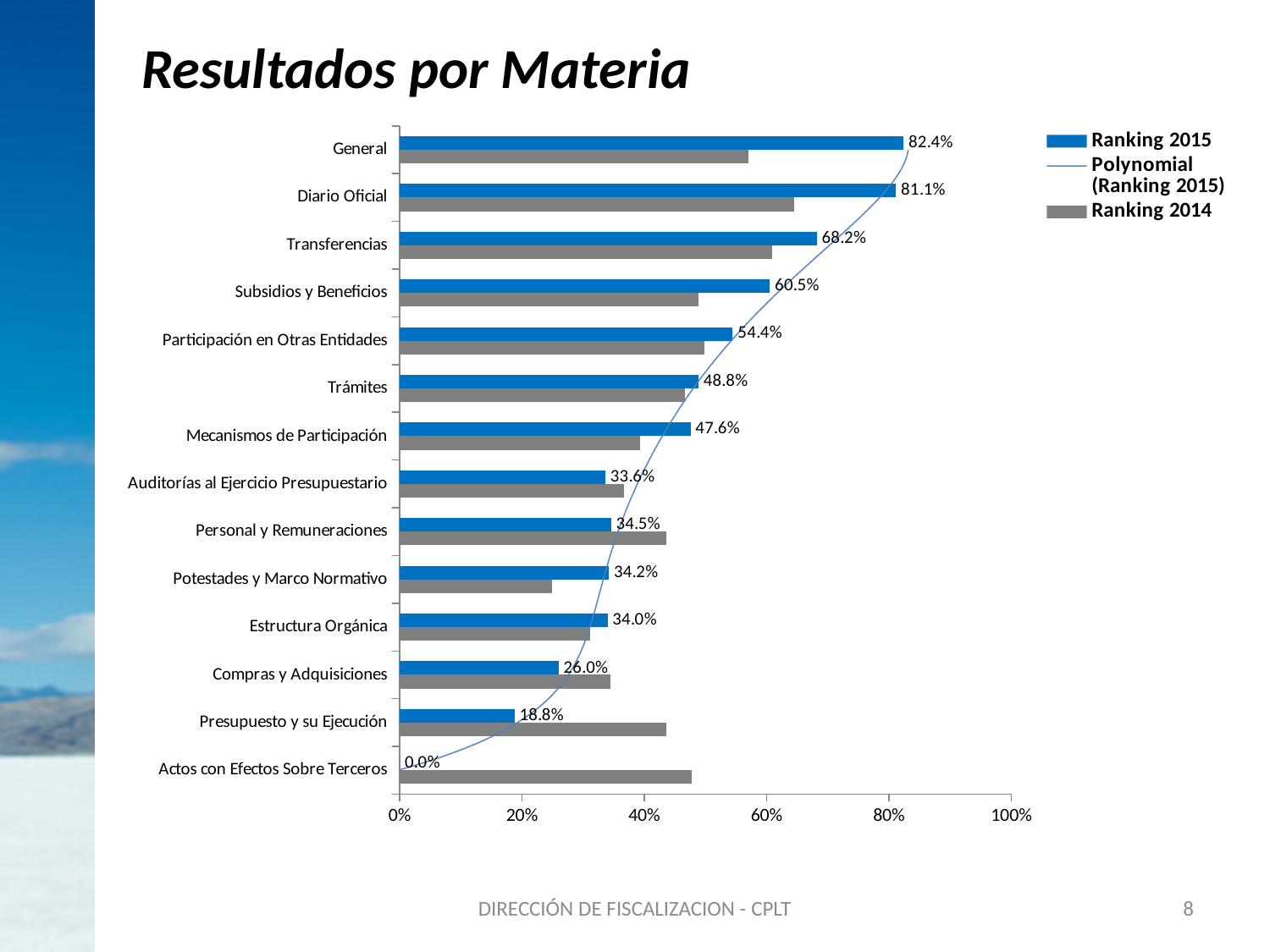
Is the Ranking 2014 value for Potestades y Marco Normativo greater or less than 40%? less What kind of chart is shown on the slide? Bar chart What is the difference between the Ranking 2015 values for General and Diario Oficial? 1.3 percentage points Which category has the lowest Ranking 2015 value? Actos con Efectos Sobre Terceros What is the Ranking 2015 value for General? 82.4% Which has a larger Ranking 2015 value, Mecanismos de Participación or Auditorías al Ejercicio Presupuestario? Mecanismos de Participación What is the Ranking 2015 value for Presupuesto y su Ejecución? 18.8% Which category has the highest Ranking 2015 value? General How many entries does the legend list? 3 How many categories are shown on the chart? 14 What is the Ranking 2015 value for Trámites? 48.8% Is the Ranking 2014 value for Actos con Efectos Sobre Terceros greater or less than 40%? greater